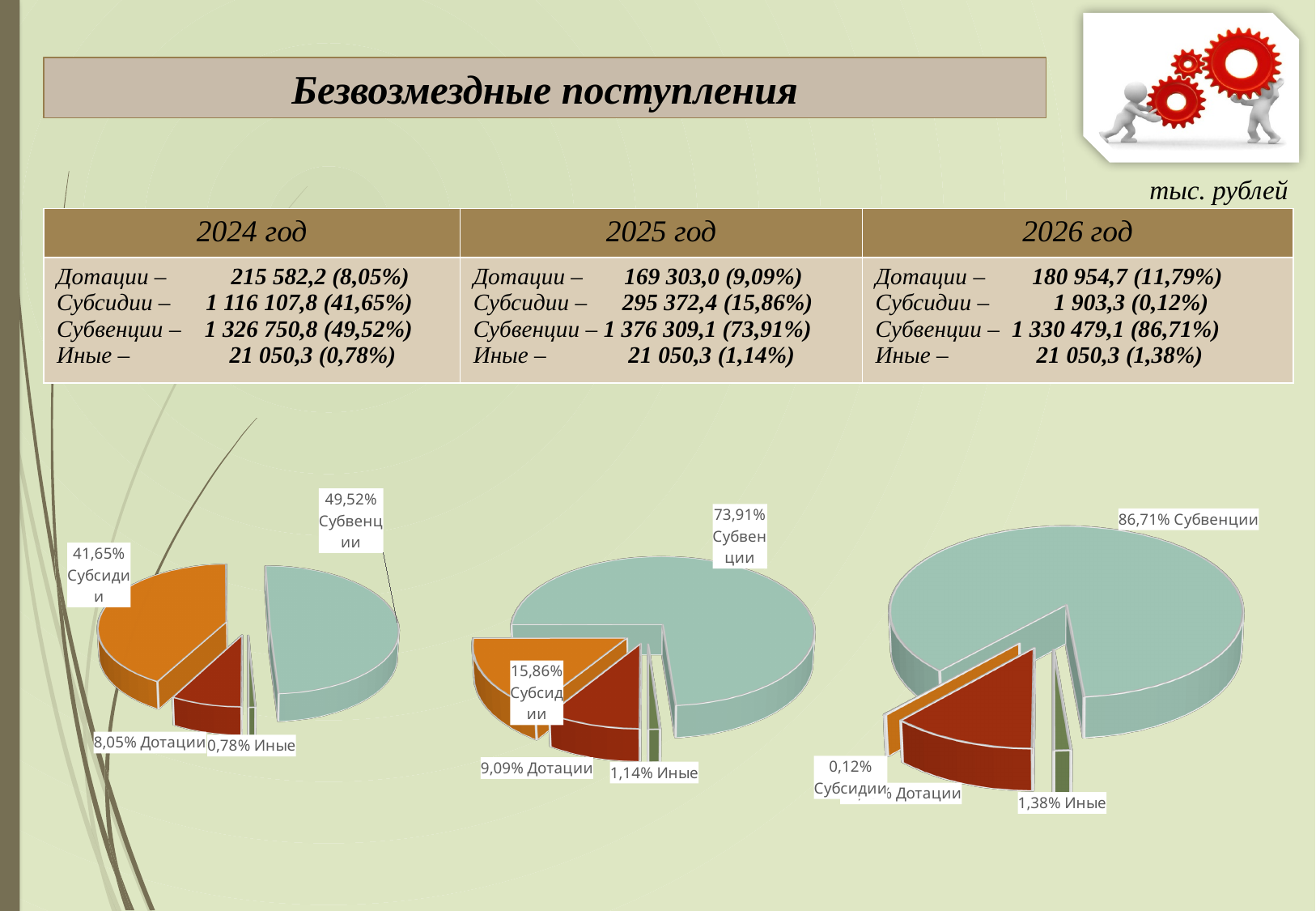
In the left pie chart (2024), which is larger: the Субсидии slice or the Дотации slice? Субсидии In the left pie chart (2024), what share is labelled for Субсидии? 41,65% In the right pie chart (2026), what share is labelled for Субсидии? 0,12% In the middle pie chart (2025), what share is labelled for Дотации? 9,09% In the left pie chart (2024), which category has the smallest slice? Иные In the middle pie chart (2025), what is the difference between the Субсидии share and the Дотации share? 6,77% How many pie charts are on the slide? 3 What type of charts are shown on the slide? Pie charts In the middle pie chart (2025), which category has the largest slice? Субвенции